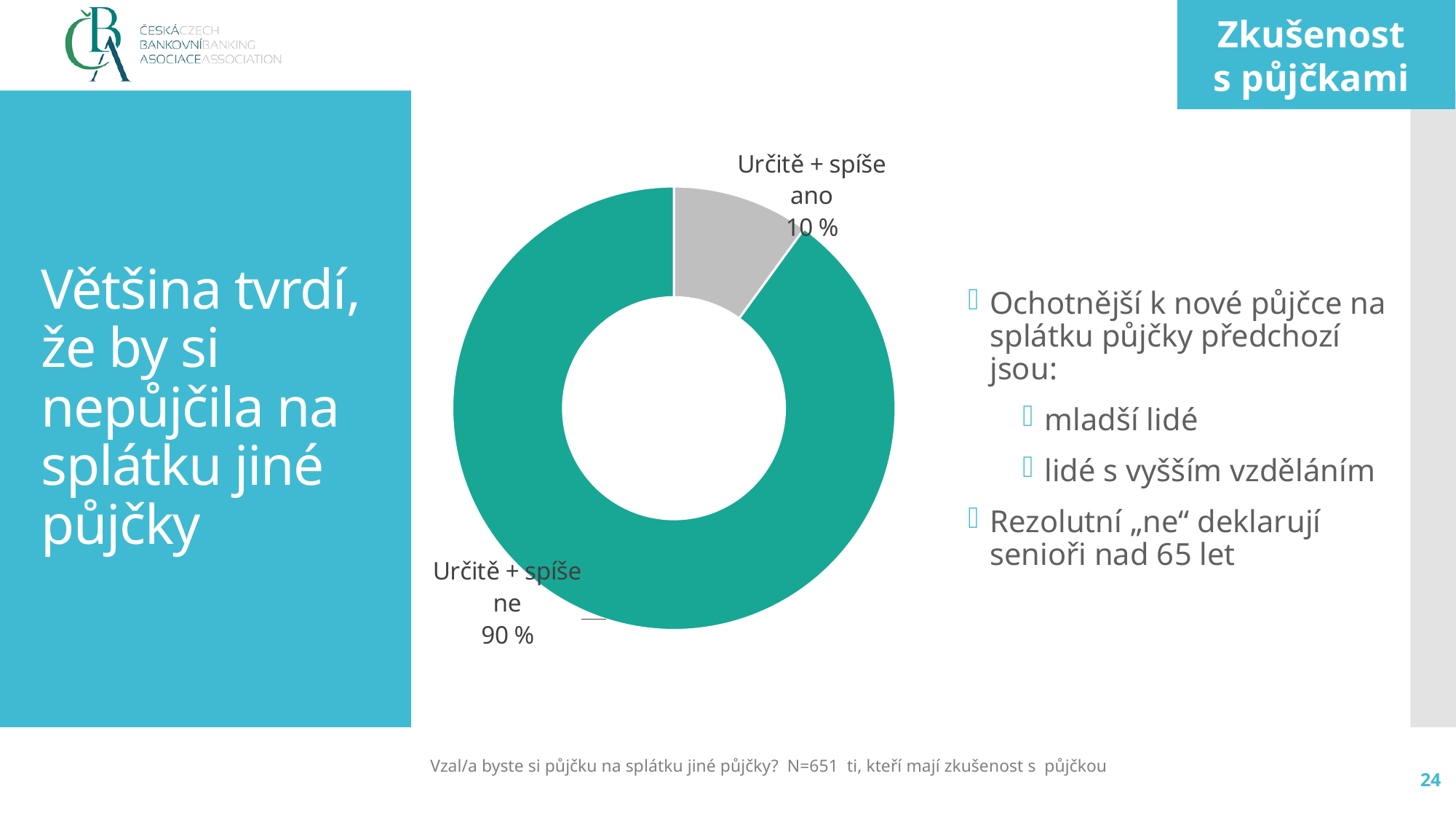
What is the value for "Určitě + spíše ne"? 90 % What is the value for "Určitě + spíše ano"? 10 % How many categories does the chart show? 2 What kind of chart is shown on the slide? Doughnut (pie) chart Which category has the largest share of the chart? Určitě + spíše ne Which is larger: the value for "Určitě + spíše ano" or "Určitě + spíše ne"? Určitě + spíše ne What share of the chart does the "Určitě + spíše ano" slice represent? 10 % What colour is the "Určitě + spíše ano" segment of the chart? Grey What is the difference between the values for "Určitě + spíše ne" and "Určitě + spíše ano"? 80 % What colour is the "Určitě + spíše ne" segment of the chart? Teal (green) Which category has the smallest share of the chart? Určitě + spíše ano